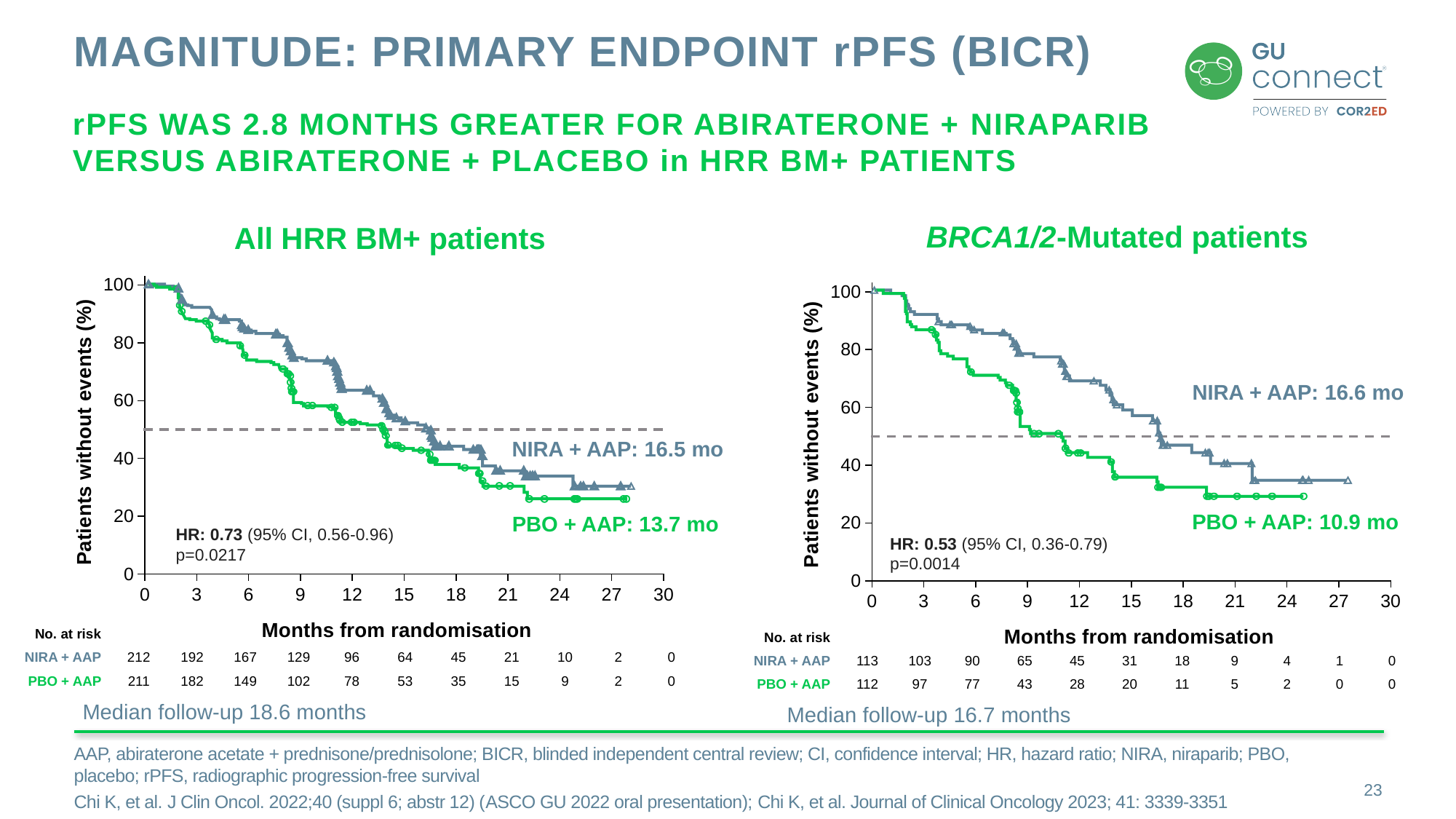
In the 'BRCA1/2-Mutated patients' chart, what is the difference in median rPFS between NIRA + AAP and PBO + AAP? 5.7 mo In the 'All HRR BM+ patients' chart, what is the median rPFS shown for NIRA + AAP? 16.5 mo In the 'BRCA1/2-Mutated patients' chart, what is the median rPFS shown for PBO + AAP? 10.9 mo In the 'All HRR BM+ patients' chart, how many NIRA + AAP patients were at risk at 12 months? 96 How many treatment arms are plotted in the 'BRCA1/2-Mutated patients' chart? 2 In the 'All HRR BM+ patients' chart, which arm has the longer median rPFS, NIRA + AAP or PBO + AAP? NIRA + AAP In the 'All HRR BM+ patients' chart, what hazard ratio is reported? 0.73 In the 'All HRR BM+ patients' chart, what is the difference in median rPFS between NIRA + AAP and PBO + AAP? 2.8 mo In the 'BRCA1/2-Mutated patients' chart, do the curves rise or fall as months from randomisation increase? fall In the 'BRCA1/2-Mutated patients' chart, how many PBO + AAP patients were at risk at 9 months? 43 In the 'BRCA1/2-Mutated patients' chart, what p-value is reported? p=0.0014 In the 'All HRR BM+ patients' chart, is the NIRA + AAP curve at 24 months greater or less than 40%? less